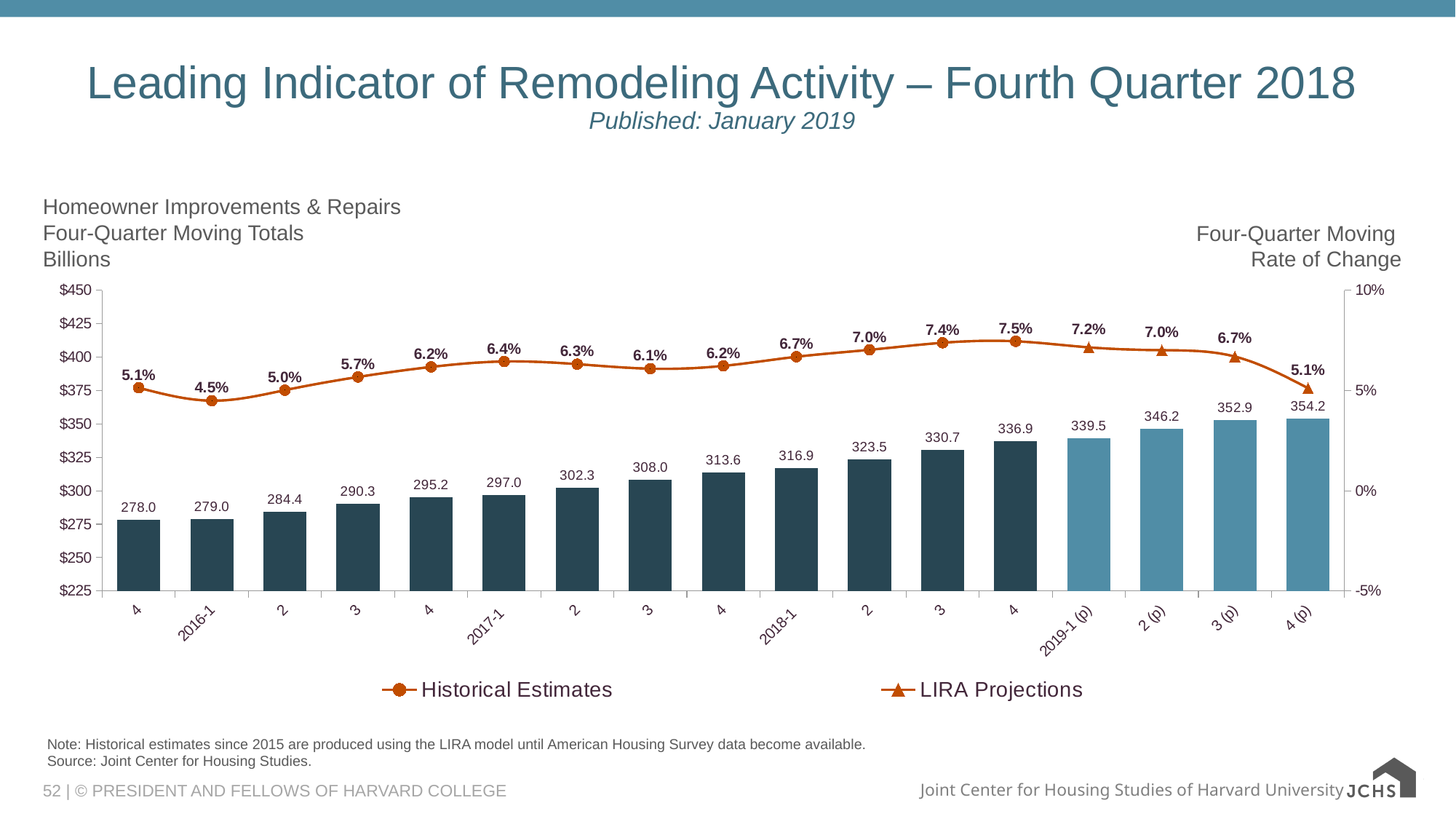
Which quarter has the highest four-quarter moving rate of change on the line? 2018 quarter 4 (7.5%) Which has the higher rate of change: quarter 2 of 2017 or quarter 2 of 2018? Quarter 2 of 2018 (7.0%) What is the four-quarter moving total (in billions) shown for 2018-1? 316.9 How many series does the legend list? 2 What kind of chart is shown on the slide? Combination bar and line chart What is the projected four-quarter moving total for 3 (p) in 2019? 352.9 Which quarter has the lowest four-quarter moving rate of change on the line? 2016-1 (4.5%) What are the two legend entries on the chart? Historical Estimates and LIRA Projections How many bars (quarters) are plotted on the chart? 17 What is the difference between the last bar, 4 (p) of 2019, and the first bar, quarter 4 of 2015, in billions? 76.2 Do the four-quarter moving total bars rise or fall from left to right across the chart? Rise What four-quarter moving rate of change is labeled for 2017-1? 6.4%